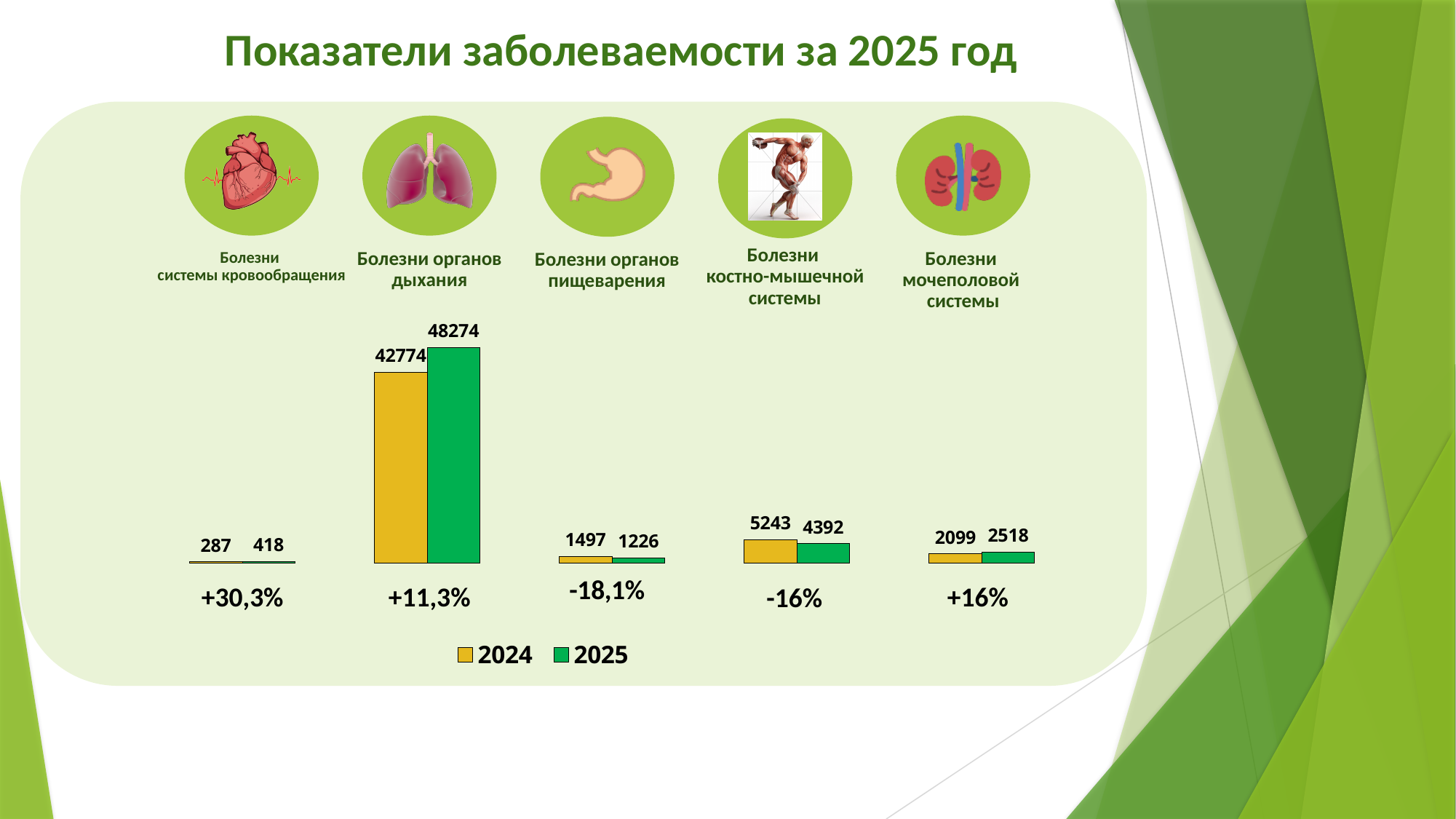
What is the difference between the 2025 and 2024 values for Болезни органов дыхания? 5500 For Болезни органов пищеварения, which year has the larger value, 2024 or 2025? 2024 What is the 2025 value for Болезни органов дыхания? 48274 What is the difference between the 2024 and 2025 values for Болезни костно-мышечной системы? 851 What is the 2024 value for Болезни мочеполовой системы? 2099 Which category has the highest 2025 value? Болезни органов дыхания How many categories are shown in the chart? 5 What is the 2024 value for Болезни костно-мышечной системы? 5243 What is the 2025 value for Болезни системы кровообращения? 418 What kind of chart is shown on the slide? Bar chart Which category has the lowest 2024 value? Болезни системы кровообращения How many series does the legend list? 2